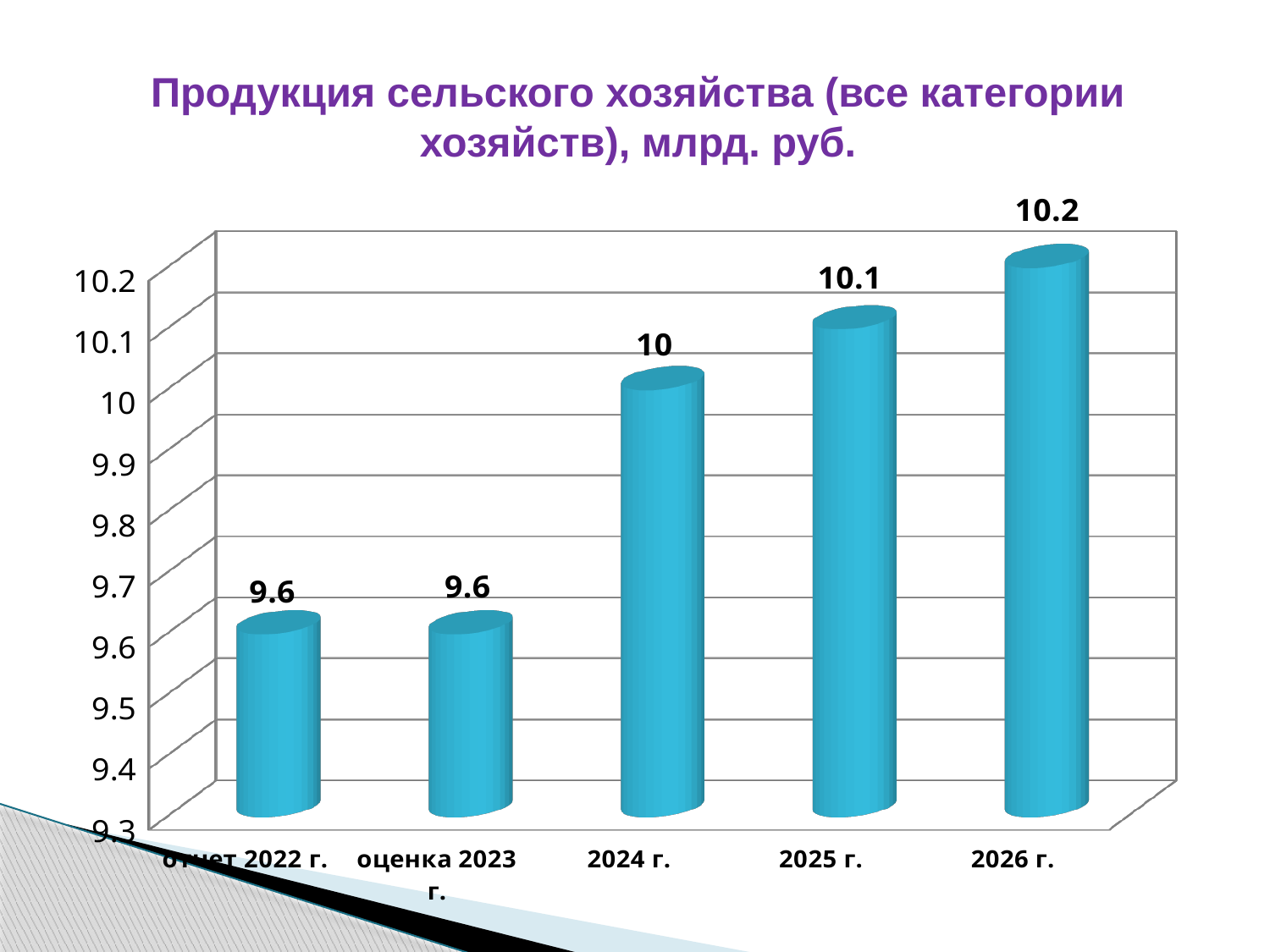
What is the difference between the values for 2026 г. and отчет 2022 г.? 0.6 What is the value for 2024 г.? 10 Which is larger, the value for 2024 г. or the value for оценка 2023 г.? 2024 г. What is the value for отчет 2022 г.? 9.6 Do the values generally rise or fall from left to right along the x axis? rise What is the difference between the values for 2025 г. and 2024 г.? 0.1 Is the value for 2025 г. greater or less than 10? greater How many categories are shown on the x axis? 5 What is the value for 2025 г.? 10.1 What kind of chart is shown on the slide? bar chart What is the value for 2026 г.? 10.2 Which category has the highest value? 2026 г.